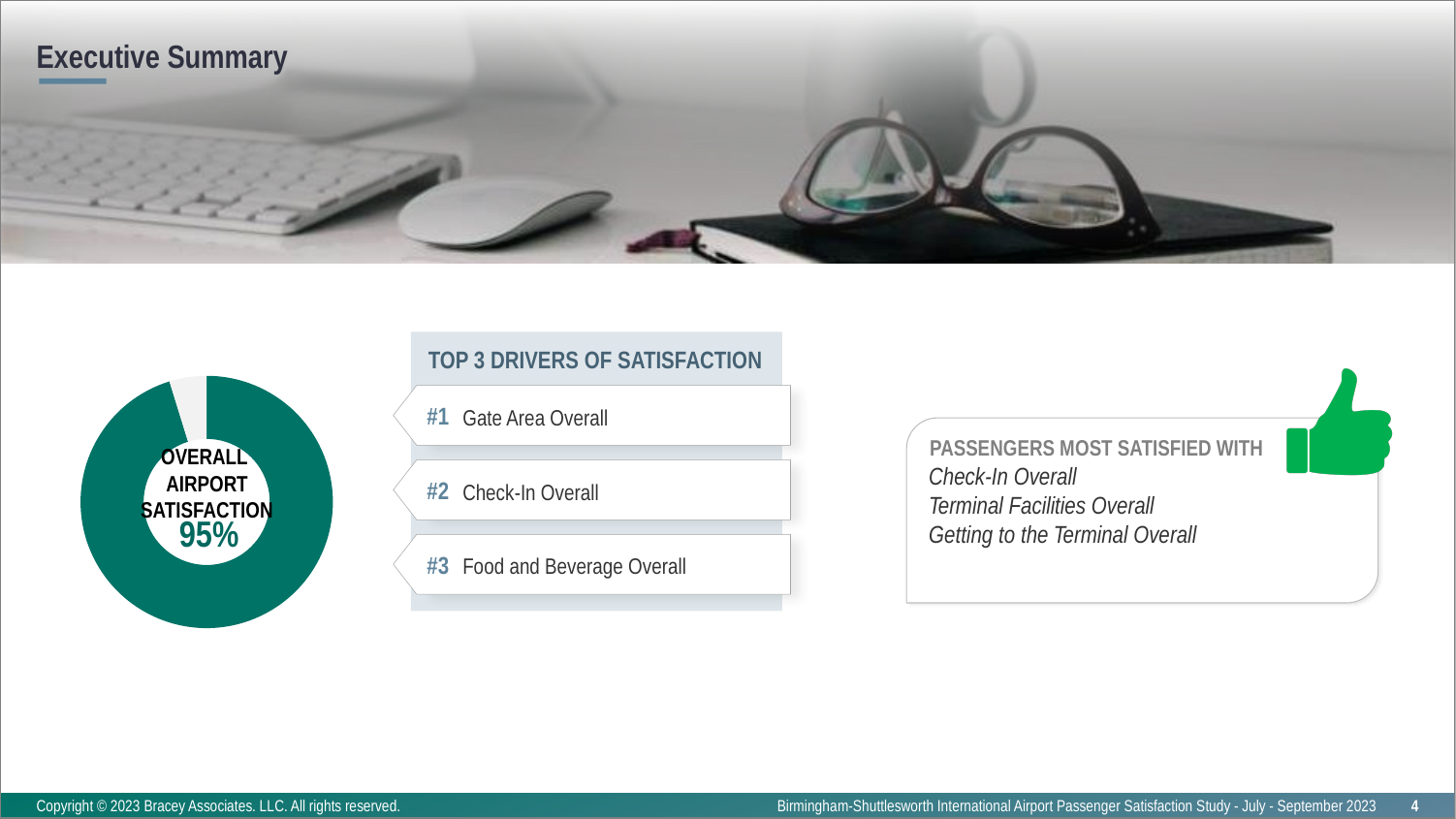
What kind of chart is used to show overall airport satisfaction? Donut (pie) chart What share of the donut chart does the green slice represent? 95% What label appears in the centre of the donut chart above the percentage? OVERALL AIRPORT SATISFACTION How many slices does the donut chart have? 2 What colour is the larger slice of the donut chart? Green Which slice of the donut chart is larger, the green one or the grey one? The green one What percentage is shown in the centre of the donut chart? 95%